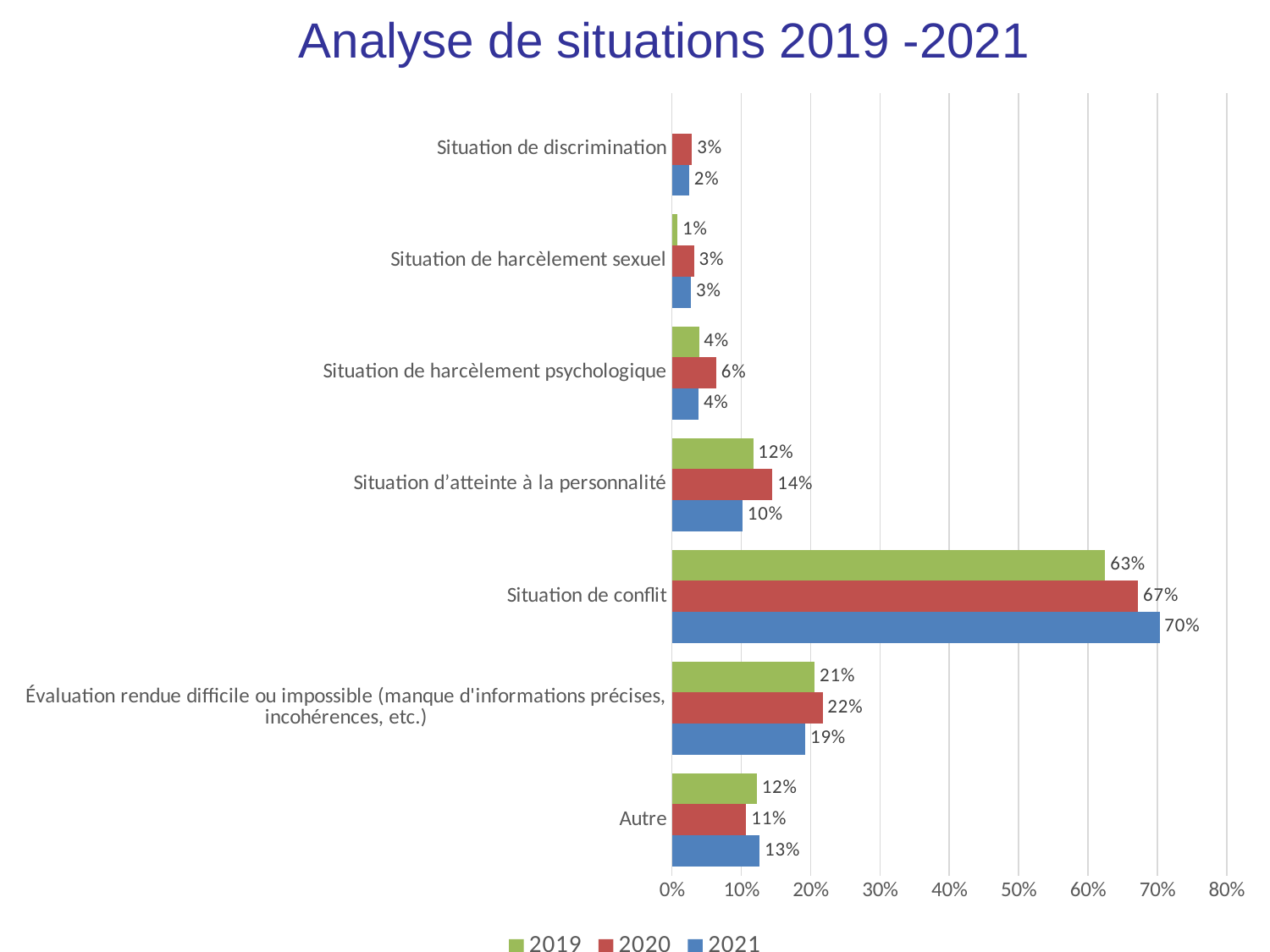
Which category has the highest value in 2019? Situation de conflit Which is larger for Autre: the 2021 value or the 2020 value? 2021 What is the value for Situation d'atteinte à la personnalité in 2020? 14% How many series does the legend list? 3 What is the value for Situation de conflit in 2021? 70% Which colour represents the 2020 series in the legend? Red What is the title of the chart? Analyse de situations 2019 -2021 What is the 2019 value for Évaluation rendue difficile ou impossible (manque d'informations précises, incohérences, etc.)? 21% Which category has the lowest value in 2021? Situation de discrimination What is the difference between the 2021 and 2019 values for Situation de conflit? 7% What kind of chart is shown on the slide? Bar chart How many categories are shown on the chart? 7